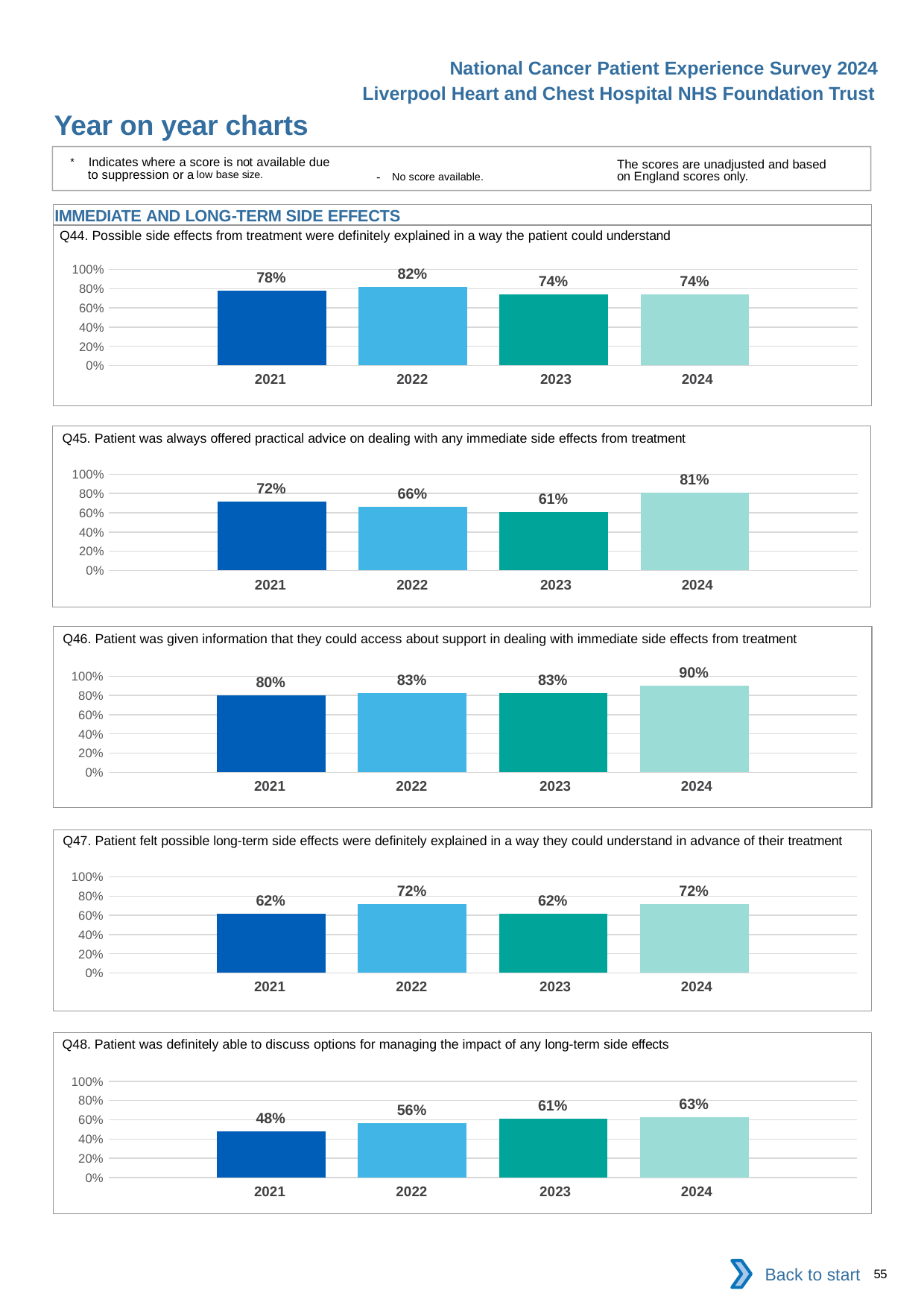
In the Q48 chart, how many years are plotted? 4 In the Q47 chart, what is the value for 2021? 62% In the Q45 chart, which year has the lowest value? 2023 In the Q47 chart, which is larger, the value for 2022 or the value for 2023? 2022 In the Q44 chart, what is the value for 2022? 82% How many charts are shown on the slide? 5 In the Q48 chart, do the values rise or fall from 2021 to 2024? rise In the Q48 chart, is the value for 2021 greater or less than 60%? less In the Q45 chart, which year has the highest value? 2024 In the Q46 chart, what is the difference between the 2024 value and the 2021 value? 10% What kind of chart is the Q44 chart? bar chart In the Q45 chart, what is the difference between the 2024 value and the 2023 value? 20%